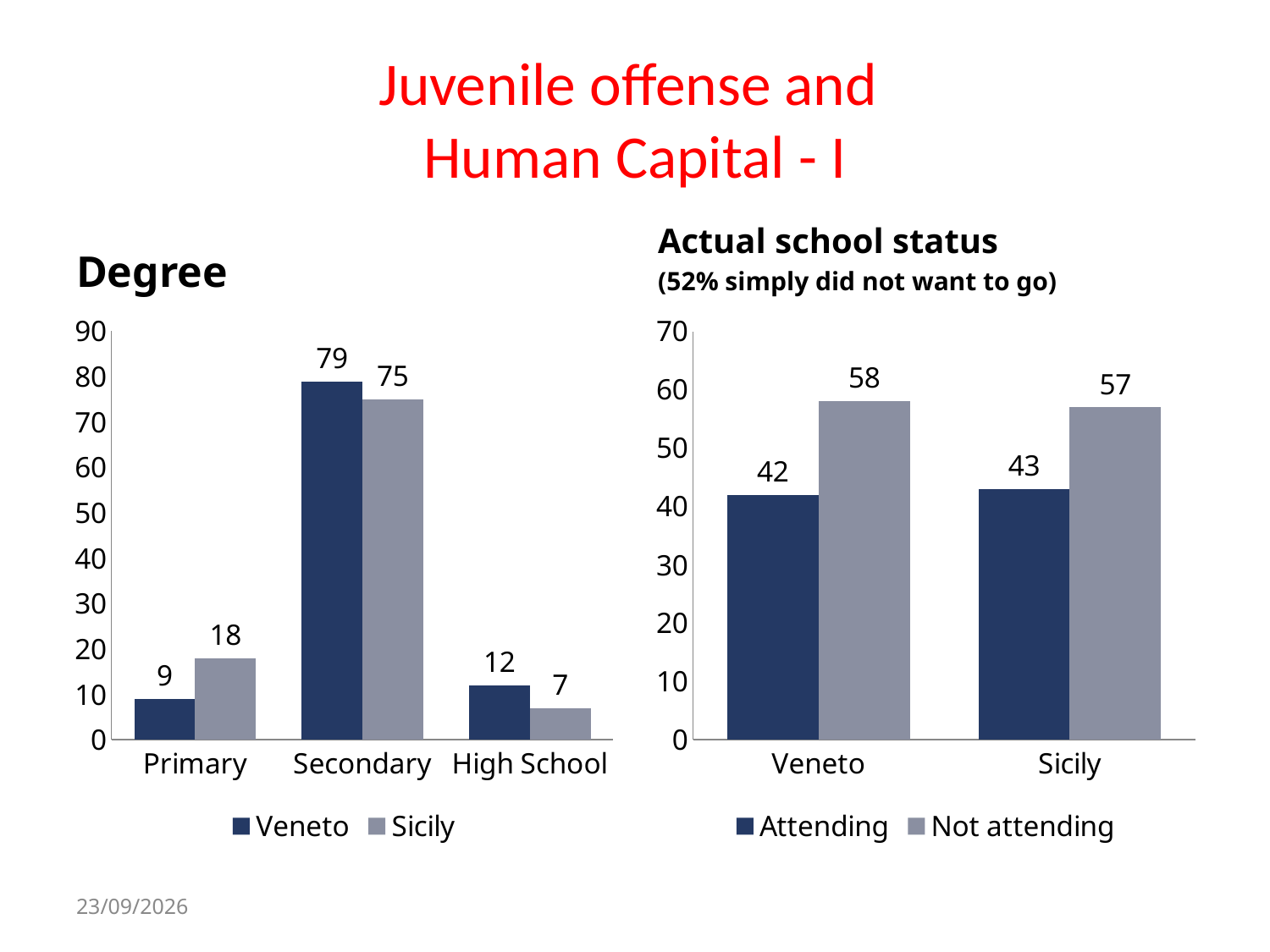
In the Degree chart, how many categories are shown on the x axis? 3 In the Degree chart, what is the difference between Veneto and Sicily in the High School category? 5 In the Degree chart, what is the value for Sicily in the Primary category? 18 In the Actual school status chart, what is the difference between Not attending and Attending in Veneto? 16 What kind of chart is the Actual school status chart? Bar chart In the Actual school status chart, how many series does the legend list? 2 In the Degree chart, which is larger in the Primary category, Veneto or Sicily? Sicily In the Degree chart, what is the value for Veneto in the Secondary category? 79 In the Degree chart, which category has the highest value for Sicily? Secondary In the Actual school status chart, what is the value for Attending in Sicily? 43 In the Degree chart, which category has the lowest value for Veneto? Primary In the Actual school status chart, what is the value for Not attending in Veneto? 58